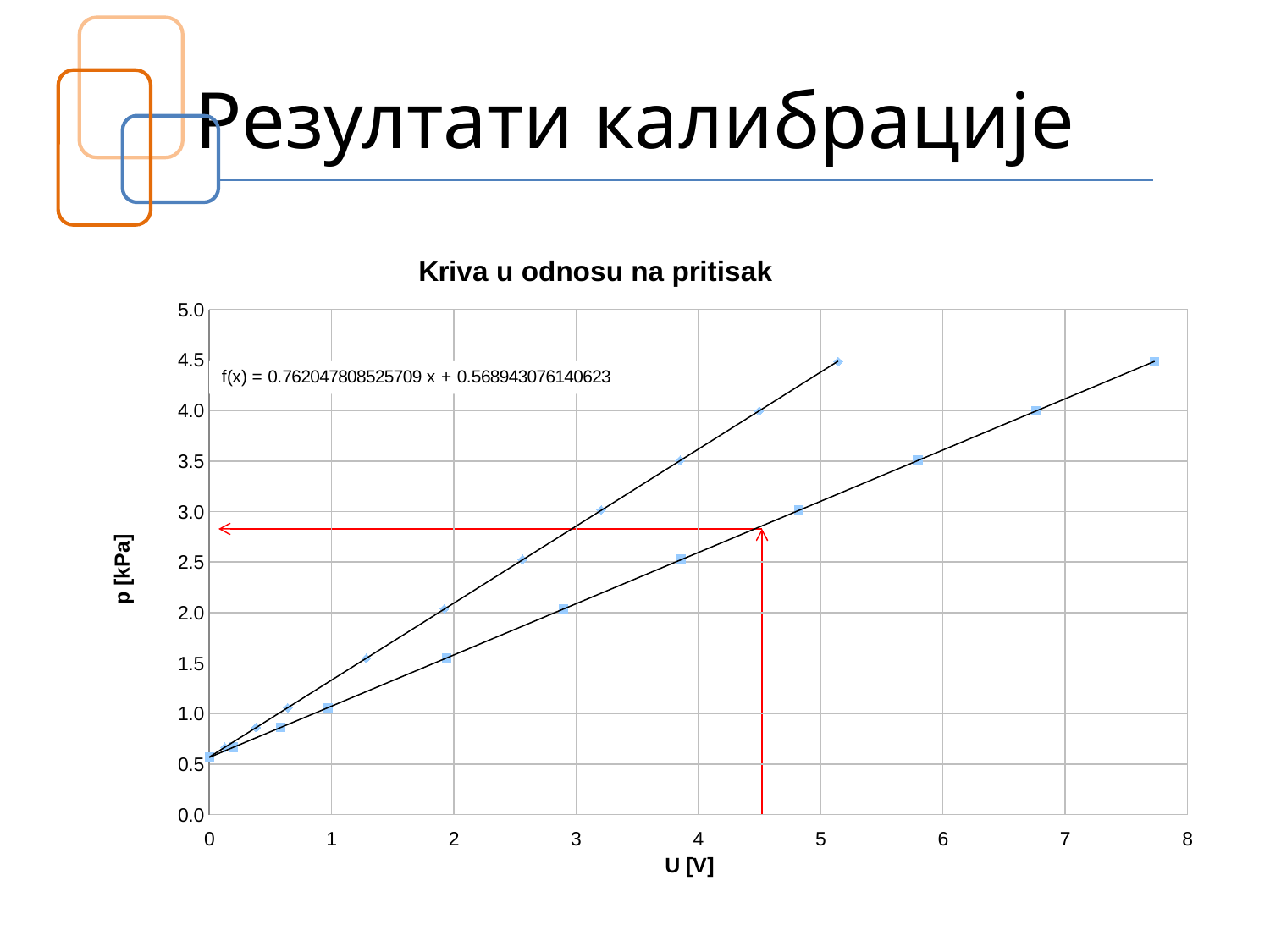
What is the title of the chart? Kriva u odnosu na pritisak Is the largest U value reached by the steeper (upper) line greater or less than 6? less What is the slope coefficient in the fitted function f(x) printed on the chart? 0.762047808525709 How many data series (lines) are plotted on the chart? 2 Is the constant term of the fitted function f(x) greater or less than 1.0? less What is the constant term in the fitted function f(x) printed on the chart? 0.568943076140623 Is the U value marked by the red vertical arrow greater or less than 4? greater At U = 4, which line has the higher p value: the steeper line ending near U = 5 or the flatter line ending near U = 8? The steeper line ending near U = 5 What is the label of the x axis of the chart? U [V] What type of chart is shown on the slide? Scatter (line) chart Do the plotted values of p rise or fall as U increases along the x axis? Rise